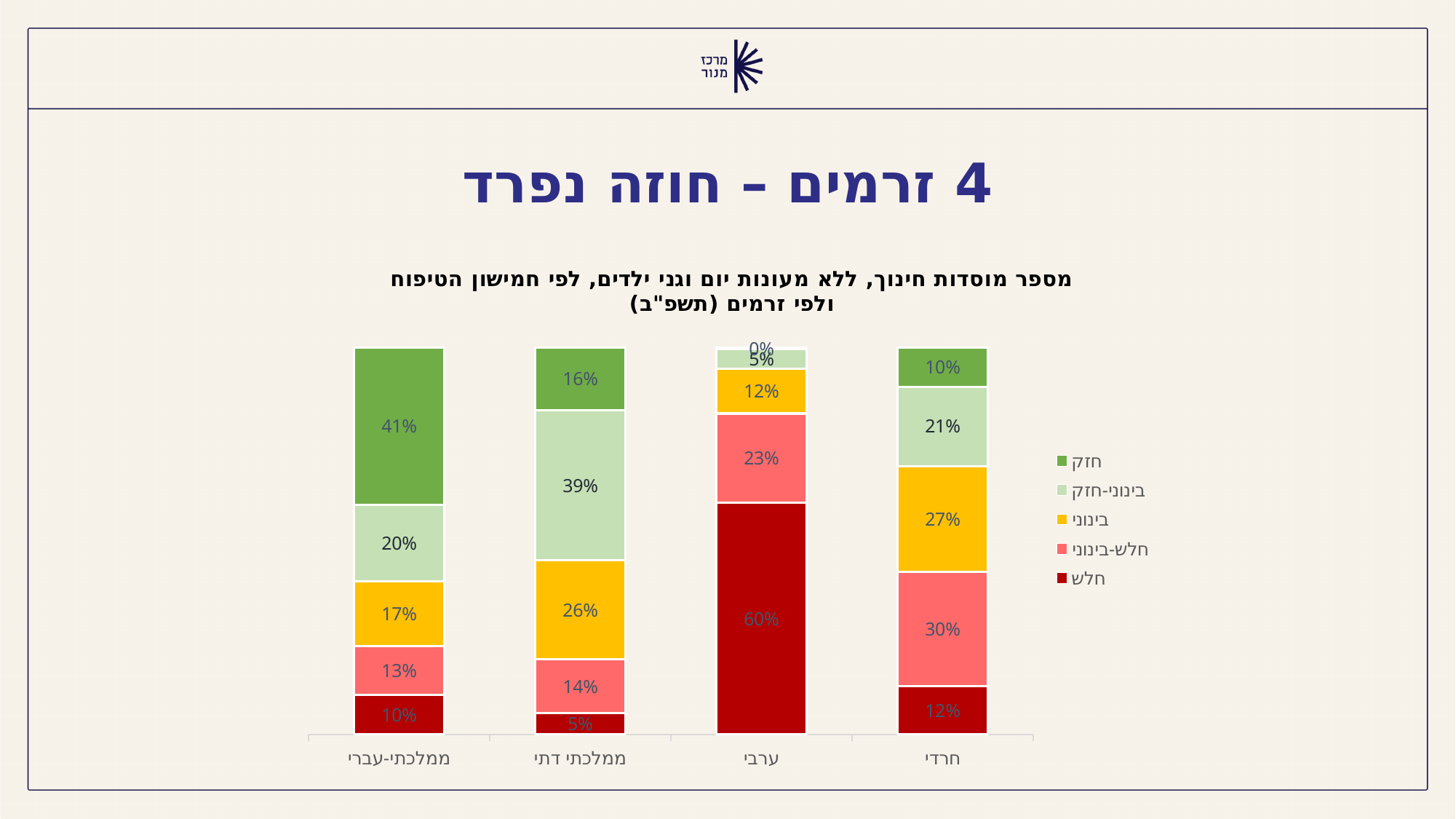
What is the difference between the בינוני values for חרדי and ממלכתי-עברי? 10% Which colour represents the חלש series in the chart? dark red Which is larger: the חלש value for ממלכתי-עברי or for ממלכתי דתי? ממלכתי-עברי Which category has the lowest value for חזק? ערבי What is the value of חזק for the ממלכתי-עברי category? 41% What is the value of חלש for the ערבי category? 60% Which category has the highest value for חלש? ערבי How many categories are shown on the x axis of the chart? 4 How many series does the legend list? 5 What type of chart is shown on the slide? stacked bar chart What is the value of בינוני-חזק for the ממלכתי דתי category? 39% What is the value of חלש-בינוני for the חרדי category? 30%